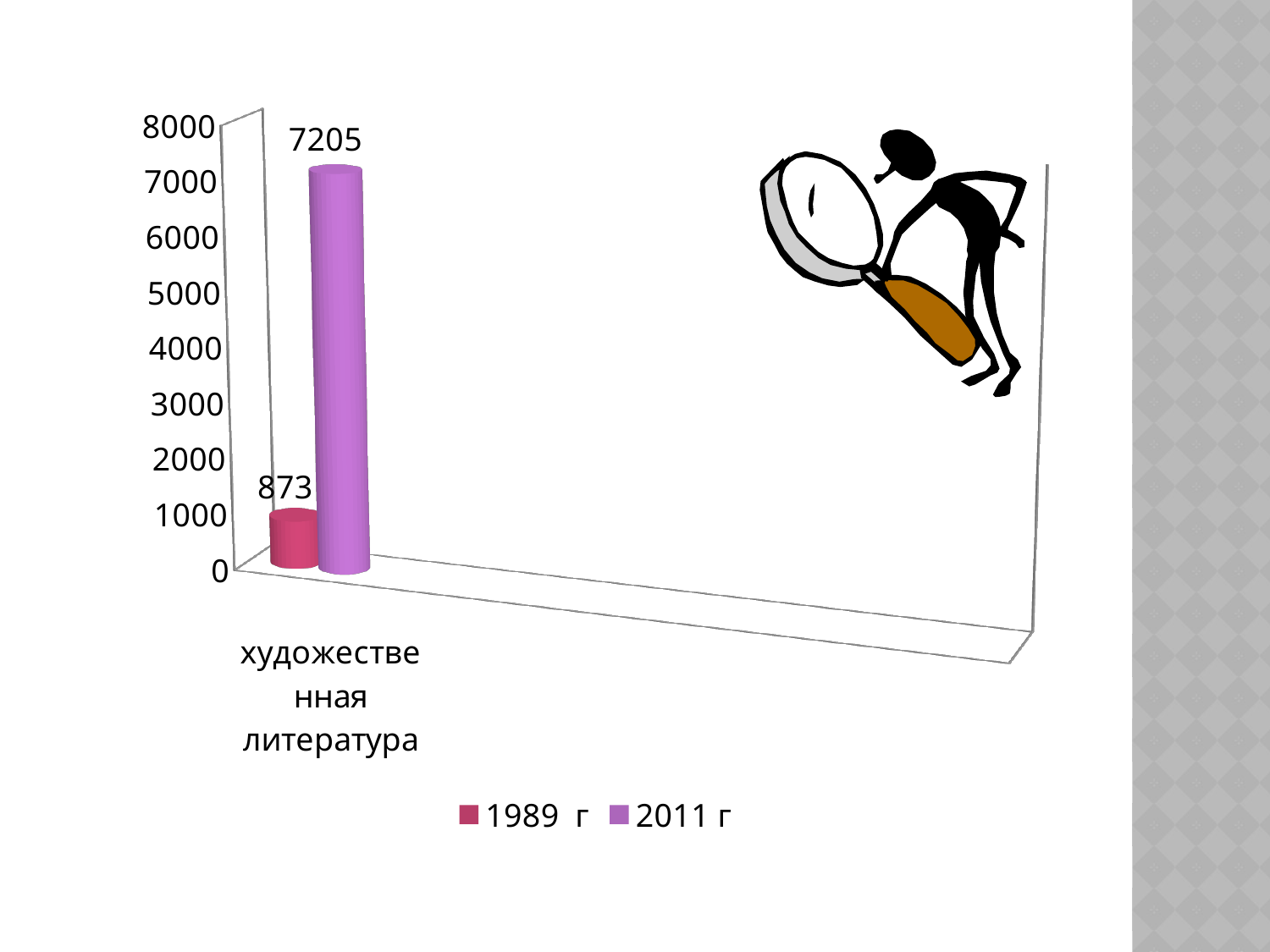
What is the value for 2011 г for художественная литература? 7205 Is the value for 2011 г greater or less than 7000? greater How many series does the legend list? 2 Which series has the higher value for художественная литература, 1989 г or 2011 г? 2011 г Is the value for 1989 г greater or less than 1000? less What is the value for 1989 г for художественная литература? 873 What is the highest value shown on the vertical axis? 8000 What kind of chart is shown on the slide? bar chart What is the difference between the 2011 г and 1989 г values for художественная литература? 6332 How many categories are shown on the x axis? 1 What is the category label shown on the x axis? художественная литература